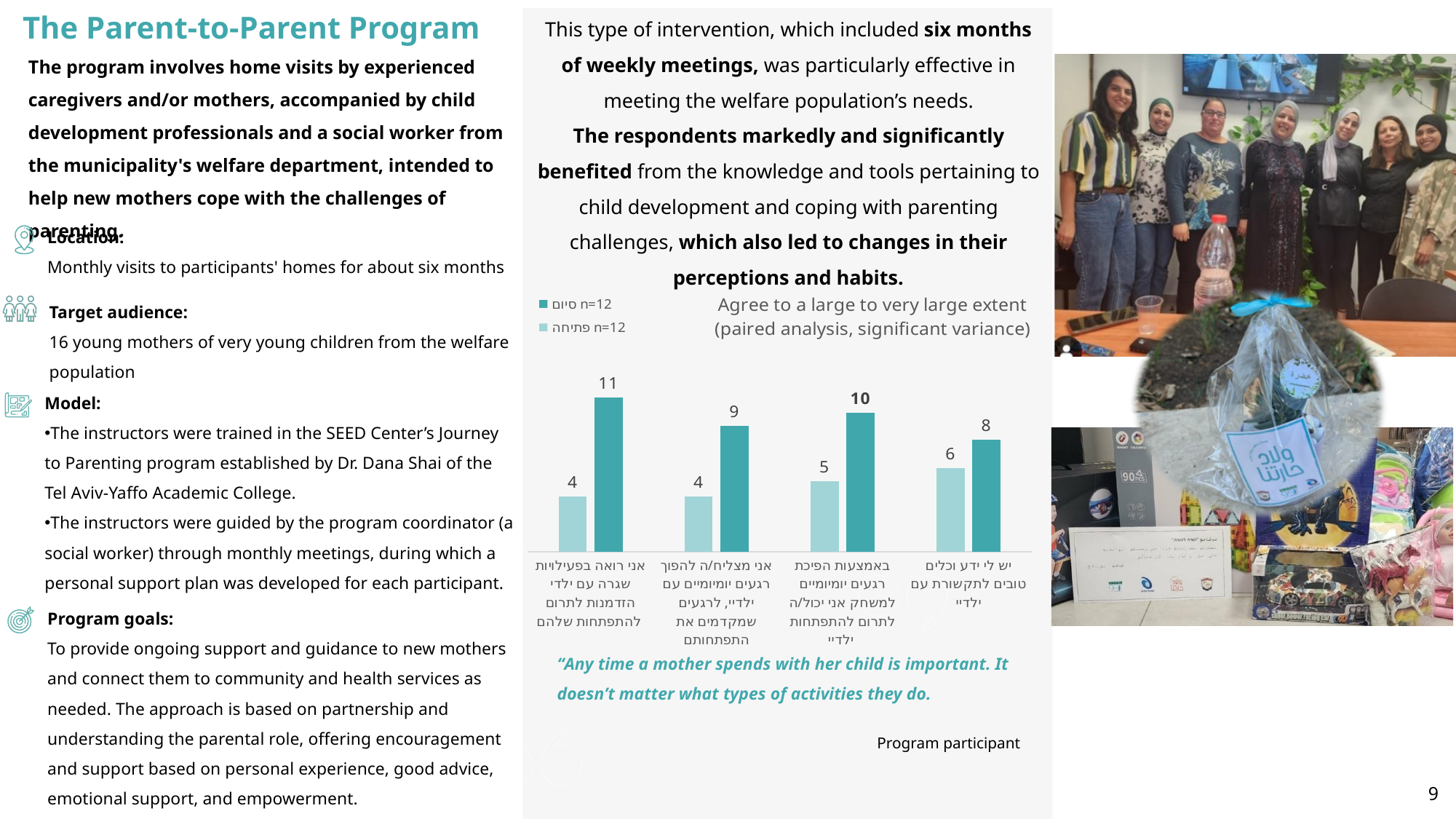
Which category has the highest value in the 'סיום n=12' series? אני רואה בפעילויות שגרה עם ילדי הזדמנות לתרום להתפתחות שלהם What is the value of the 'סיום n=12' series for the leftmost category (אני רואה בפעילויות שגרה עם ילדי הזדמנות לתרום להתפתחות שלהם)? 11 How many series does the chart legend list? 2 What is the value of the 'סיום n=12' series for the category 'יש לי ידע וכלים טובים לתקשורת עם ילדיי'? 8 How many categories are shown on the x axis of the chart? 4 What is the difference between the 'סיום n=12' and 'פתיחה n=12' values for the category 'אני מצליח/ה להפוך רגעים יומיומיים עם ילדיי, לרגעים שמקדמים את התפתחותם'? 5 For the category 'יש לי ידע וכלים טובים לתקשורת עם ילדיי', which series has the larger value, 'סיום n=12' or 'פתיחה n=12'? סיום n=12 What kind of chart is shown on the slide? bar chart Which category has the highest value in the 'פתיחה n=12' series? יש לי ידע וכלים טובים לתקשורת עם ילדיי What is the title of the chart? Agree to a large to very large extent (paired analysis, significant variance) What is the value of the 'פתיחה n=12' series for the leftmost category (אני רואה בפעילויות שגרה עם ילדי הזדמנות לתרום להתפתחות שלהם)? 4 What is the value of the 'פתיחה n=12' series for the category 'באמצעות הפיכת רגעים יומיומיים למשחק אני יכול/ה לתרום להתפתחות ילדיי'? 5